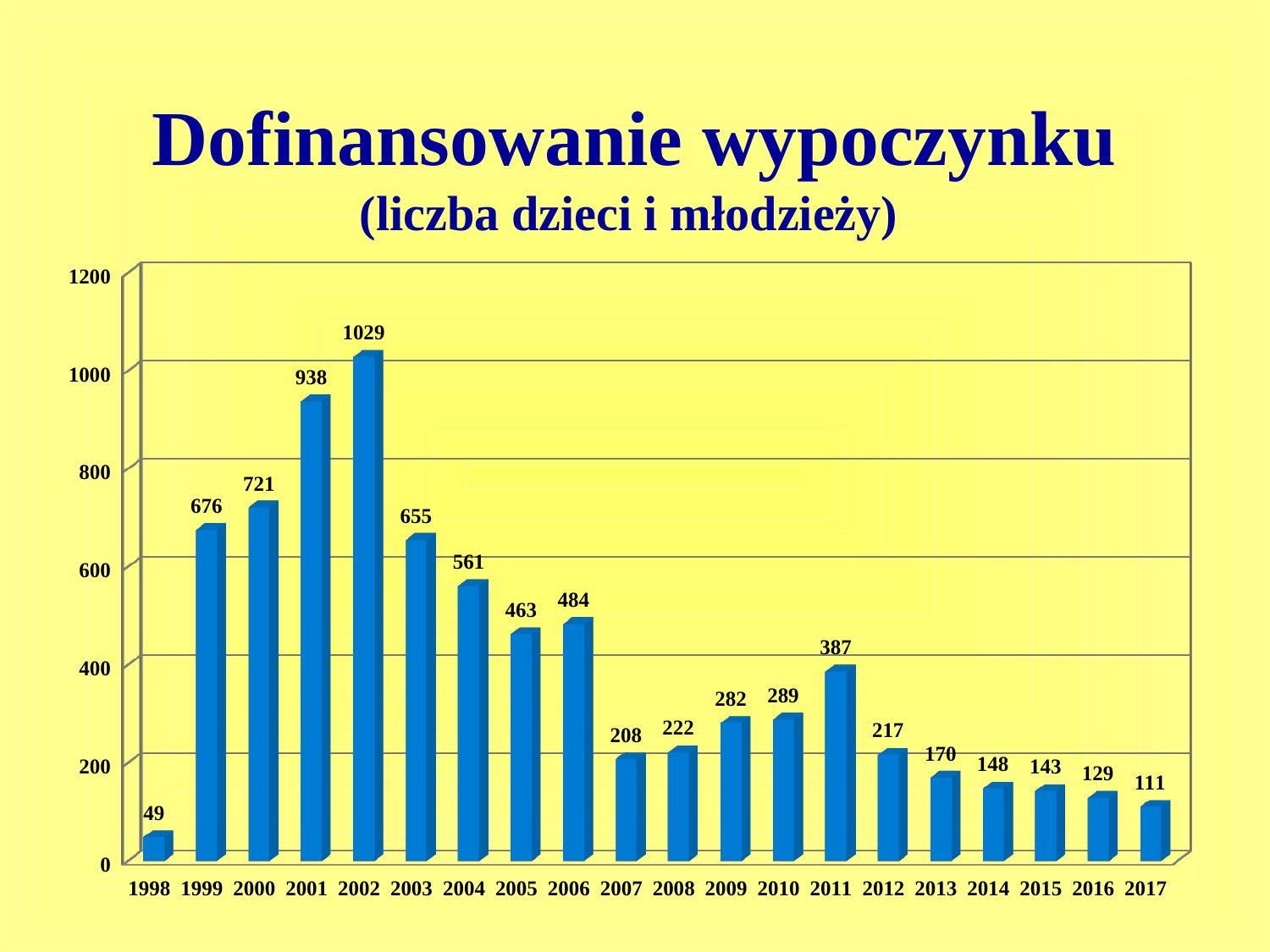
Is the value for 2004 greater or less than 600? less What is the value for 2011? 387 Which year has the highest value? 2002 Which is larger, the value for 2005 or the value for 2006? 2006 Which year has the lowest value? 1998 Do the values rise or fall from 2011 to 2017? fall How many years are shown on the x axis? 20 What is the value for 1998? 49 What is the value for 2002? 1029 What kind of chart is shown on the slide? bar chart What is the difference between the values for 2001 and 2003? 283 What is the title of the chart? Dofinansowanie wypoczynku (liczba dzieci i młodzieży)